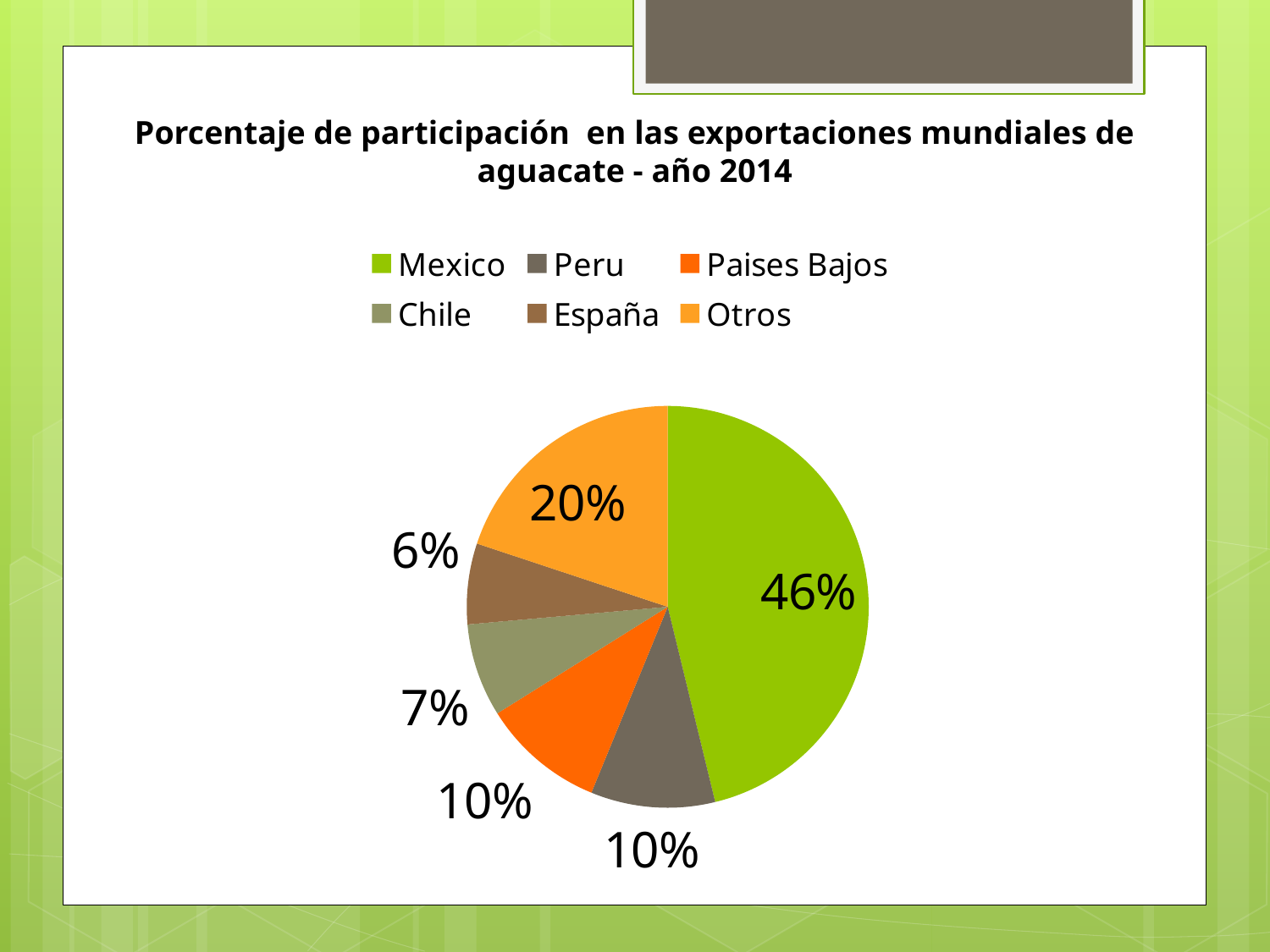
What type of chart is shown on the slide? Pie chart What is the value for Peru in the pie chart? 10% How many categories are shown in the pie chart? 6 Which is larger, the share for Chile or the share for España? Chile What year does the chart title say the data refers to? 2014 What percentage is shown for Otros in the pie chart? 20% Which category has the smallest slice of the pie chart? España What is the value for España in the pie chart? 6% What is the difference between Mexico's share and Otros' share? 26% Which category has the largest slice of the pie chart? Mexico What share of world avocado exports does Mexico hold in the pie chart? 46% What is the value for Chile in the pie chart? 7%